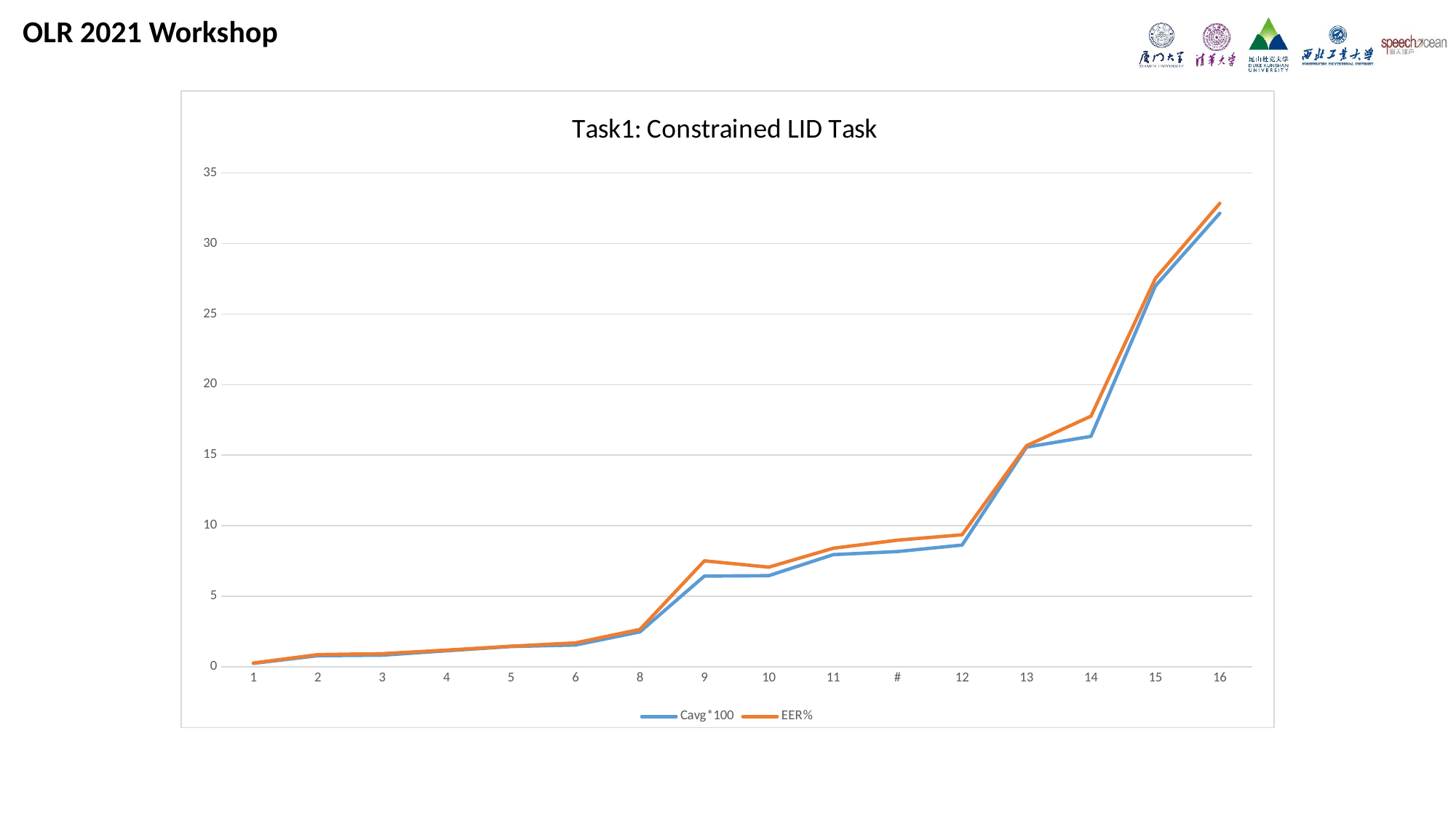
Which category has the lowest Cavg*100 value? 1 What kind of chart is shown on the slide? line chart What is the title of the chart? Task1: Constrained LID Task Is the Cavg*100 value for category 12 greater or less than 10? less Which series is drawn in orange? EER% Do the values of EER% generally rise or fall from left to right along the x axis? rise Is the EER% value for category 16 greater or less than 30? greater How many categories are shown along the x axis? 16 Is the Cavg*100 value for category 8 greater or less than 5? less Which category has the highest EER% value? 16 At category 14, which is larger, EER% or Cavg*100? EER% How many series does the legend list? 2